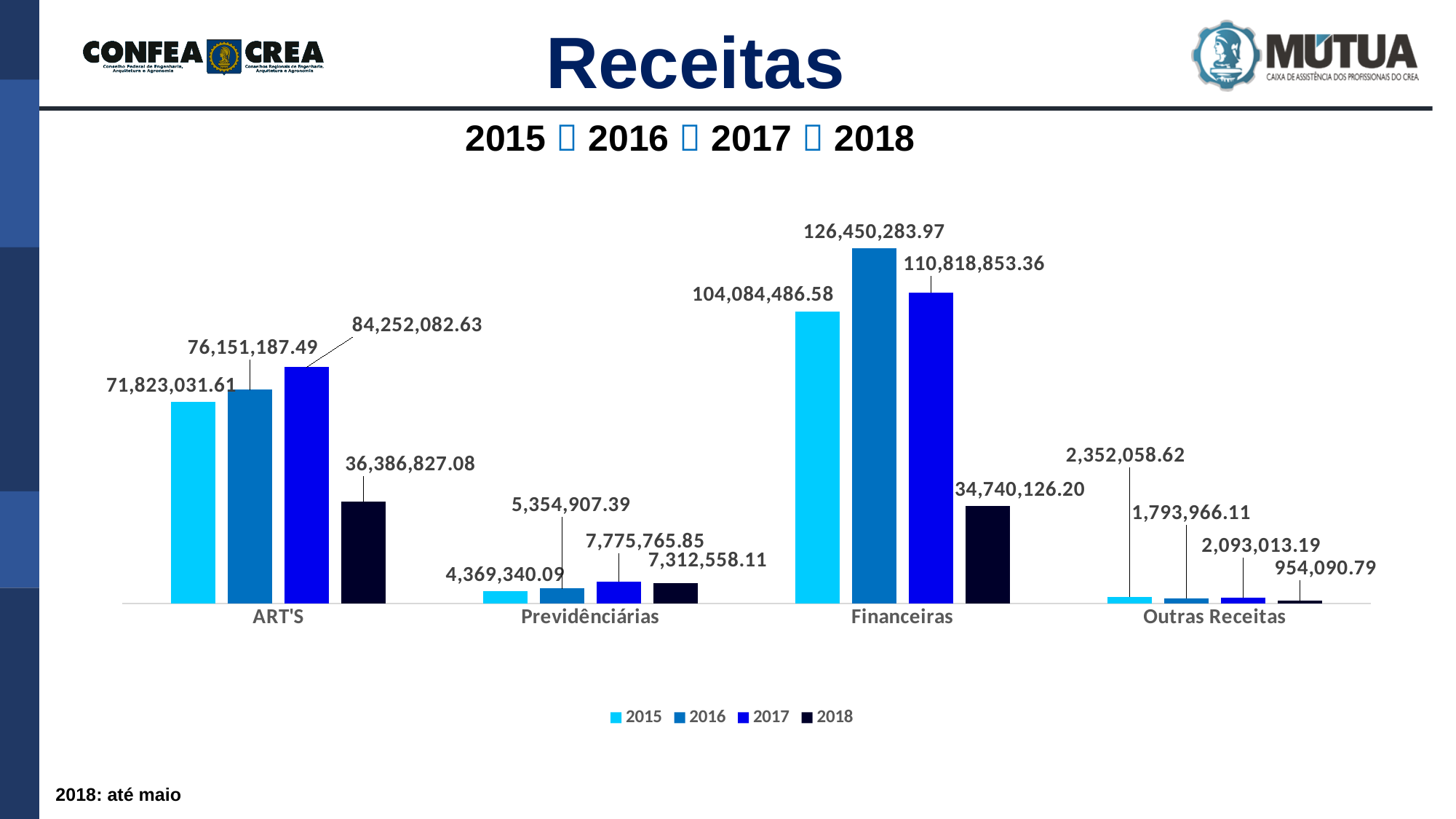
What kind of chart is shown on the slide? Bar chart What is the value for Outras Receitas in 2018? 954,090.79 What is the value for Previdênciárias in 2015? 4,369,340.09 What is the value for Financeiras in 2016? 126,450,283.97 Which category has the highest value in 2016? Financeiras What is the difference between the 2016 and 2015 values for Financeiras? 22,365,797.39 Which is larger for Previdênciárias: the 2017 value or the 2018 value? 2017 What is the difference between the 2017 and 2016 values for ART'S? 8,100,895.14 How many series does the legend list? 4 Which category has the lowest value in 2015? Outras Receitas What is the value for ART'S in 2017? 84,252,082.63 How many categories are shown on the x axis? 4